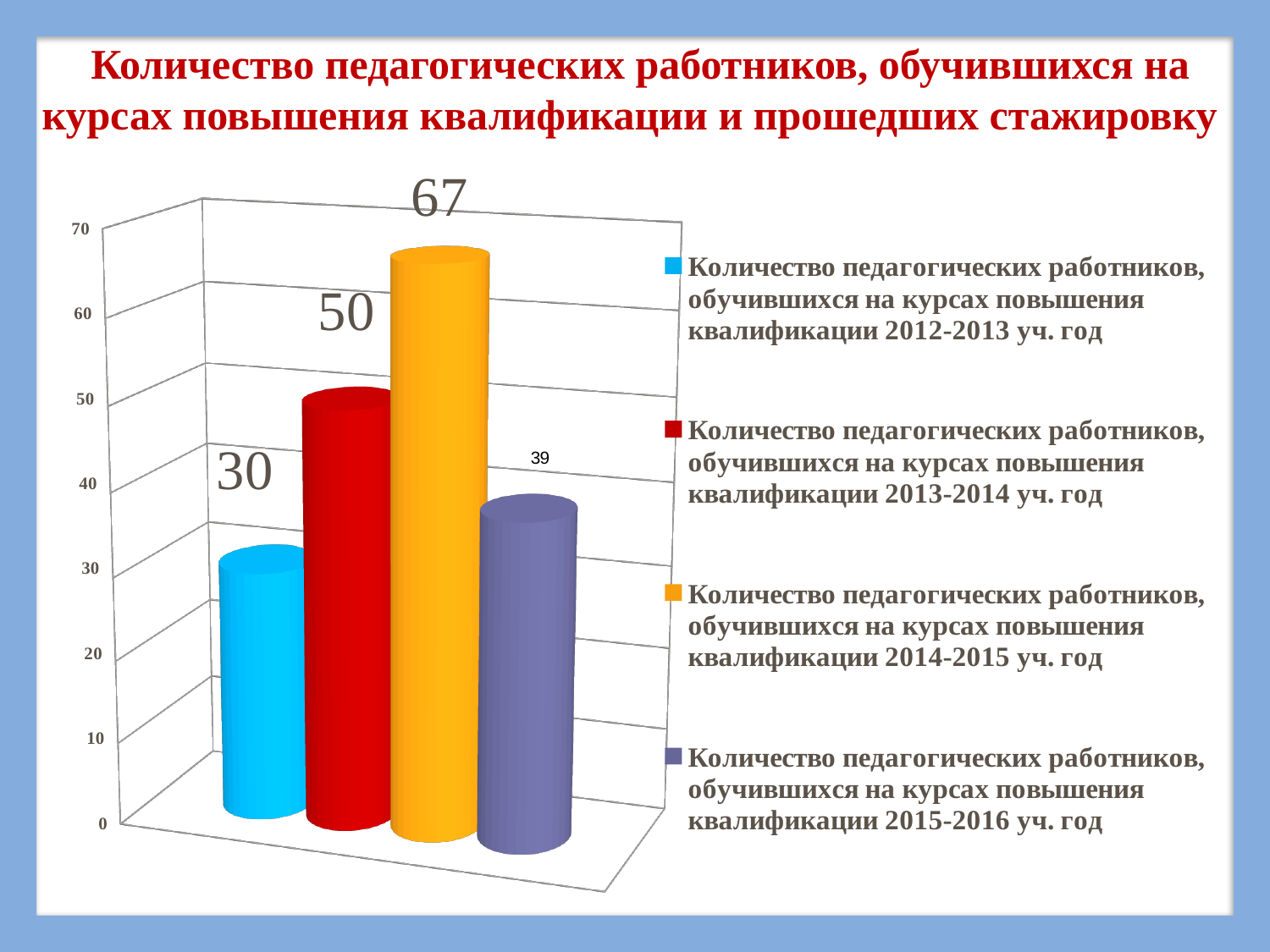
What is the number of teaching staff who completed professional development courses in the 2013-2014 academic year? 50 What kind of chart is shown on the slide? Bar chart How many series does the legend list? 4 What is the number of teaching staff who completed professional development courses in the 2012-2013 academic year? 30 What colour is the bar for the 2014-2015 academic year? Orange What is the number of teaching staff who completed professional development courses in the 2015-2016 academic year? 39 What is the difference between the values for 2014-2015 and 2013-2014? 17 Which academic year has the highest number of teaching staff who completed professional development courses? 2014-2015 уч. год Which is larger: the value for 2013-2014 or the value for 2015-2016? 2013-2014 What is the number of teaching staff who completed professional development courses in the 2014-2015 academic year? 67 What is the difference between the values for 2015-2016 and 2012-2013? 9 Which academic year has the lowest number of teaching staff who completed professional development courses? 2012-2013 уч. год